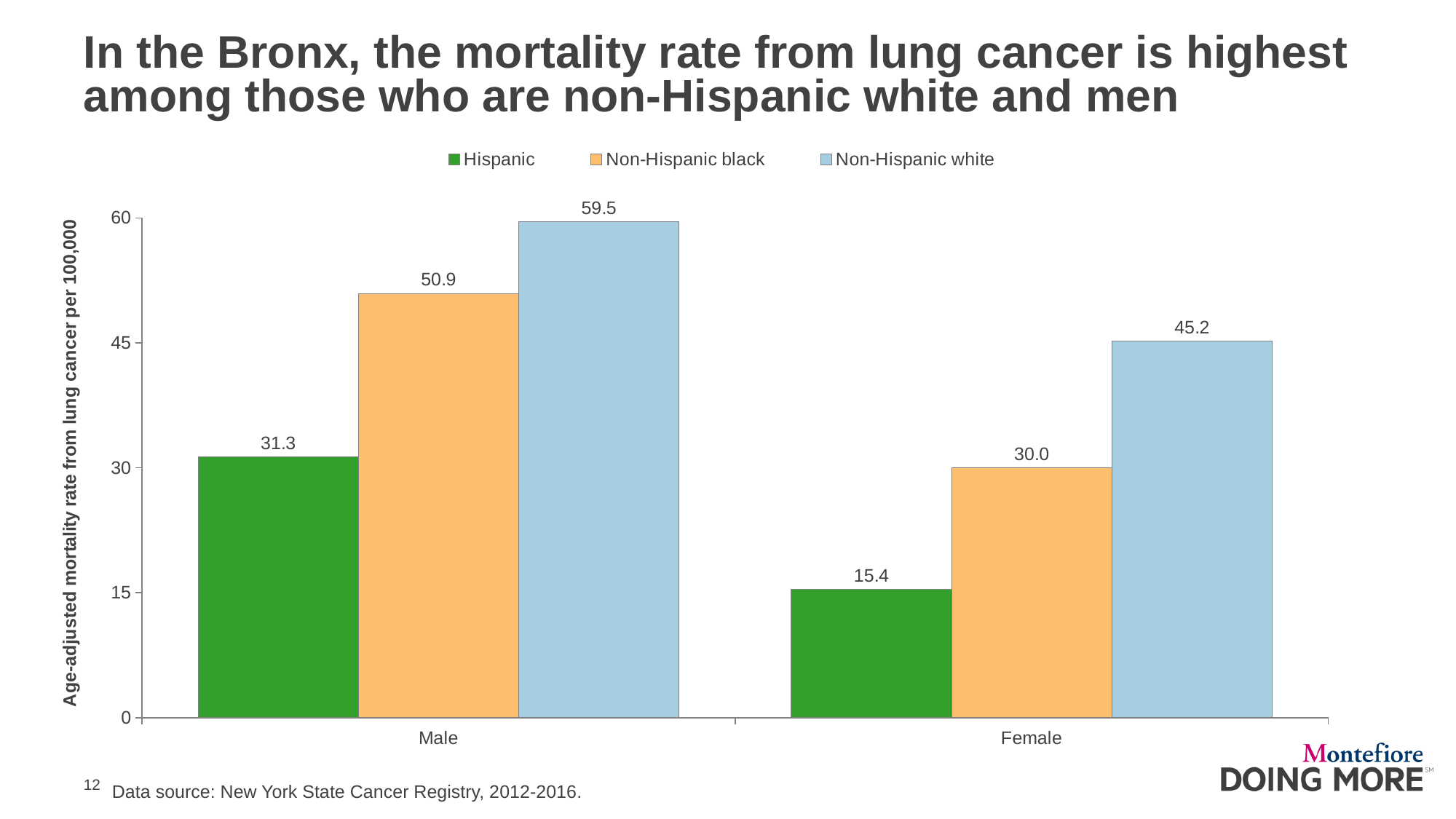
How many series does the legend list? 3 Which group has the lowest mortality rate among females? Hispanic What is the difference between the non-Hispanic white male rate and the non-Hispanic white female rate? 14.3 What is the age-adjusted lung cancer mortality rate for Hispanic males? 31.3 Which group has the highest mortality rate among males? Non-Hispanic white What is the value for non-Hispanic black females? 30.0 What kind of chart is shown on the slide? Bar chart Which is larger: the rate for Hispanic males or the rate for non-Hispanic black females? Hispanic males What is the age-adjusted lung cancer mortality rate for non-Hispanic white females? 45.2 What is the difference between the non-Hispanic black male rate and the Hispanic male rate? 19.6 Is the value for non-Hispanic black males greater or less than 45? greater How many categories are shown on the x axis? 2